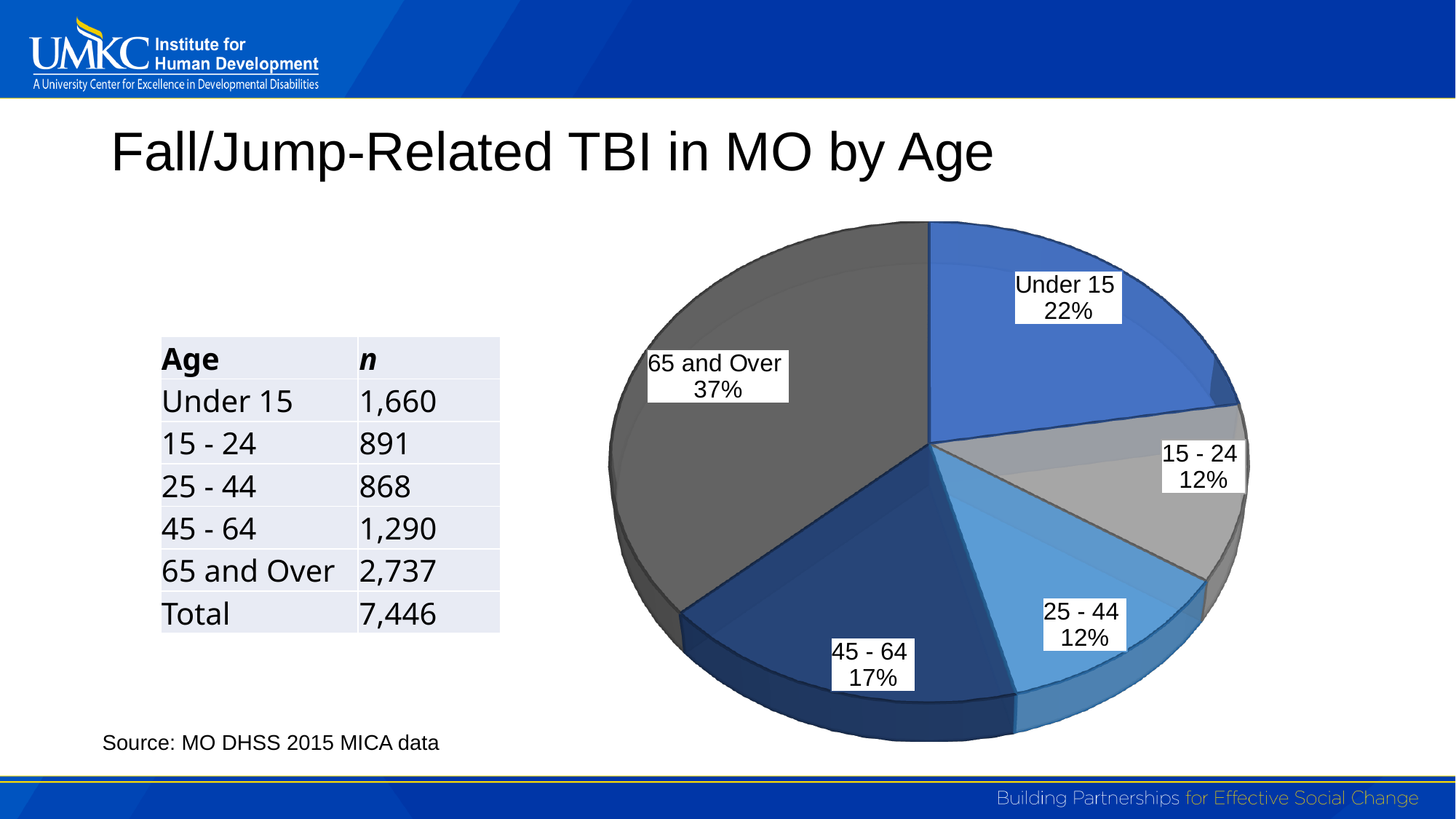
Which age group has the largest slice of the pie? 65 and Over What share of the pie does the Under 15 slice represent? 22% Which slice is larger, Under 15 or 45 - 64? Under 15 How many slices does the pie chart have? 5 What is the difference in percentage points between the 45 - 64 slice and the 25 - 44 slice? 5% What is the difference in percentage points between the 65 and Over slice and the Under 15 slice? 15% What share of the pie does the 65 and Over slice represent? 37% What data source is cited for the chart? MO DHSS 2015 MICA data What is the title of the slide containing the pie chart? Fall/Jump-Related TBI in MO by Age What share of the pie does the 45 - 64 slice represent? 17% What type of chart is shown on the slide? pie chart